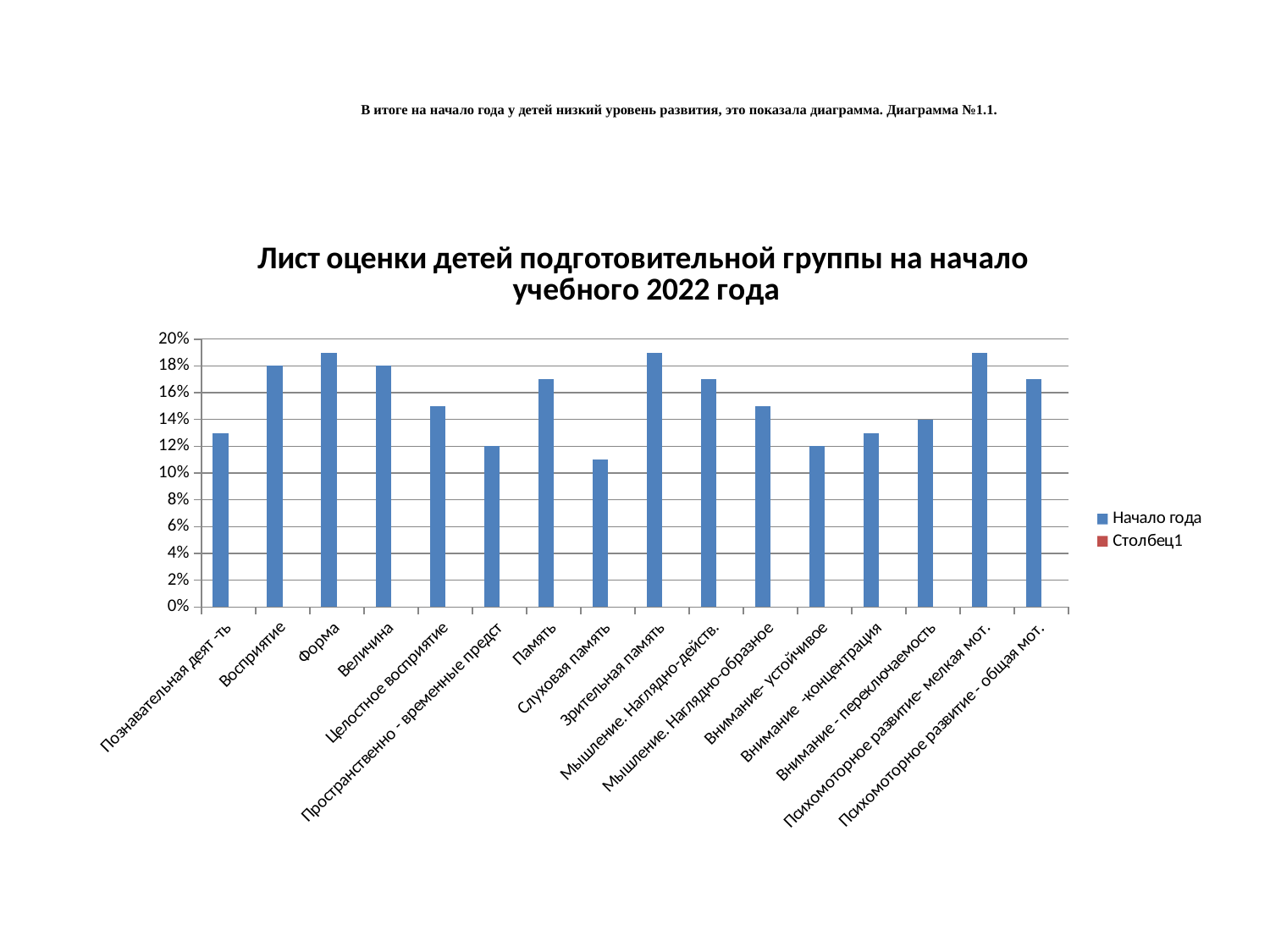
Which is larger, the value for Форма or the value for Слуховая память? Форма How many series does the chart legend list? 2 Is the value for Познавательная деят-ть greater or less than 14%? less Is the value for Внимание - концентрация greater or less than 16%? less What is the title of the chart? Лист оценки детей подготовительной группы на начало учебного 2022 года Is the value for Форма greater or less than 16%? greater What kind of chart is shown on the slide? bar chart How many categories are shown on the x axis of the chart? 16 What are the two entries in the chart legend? Начало года, Столбец1 Which is larger, the value for Восприятие or the value for Пространственно - временные предст? Восприятие